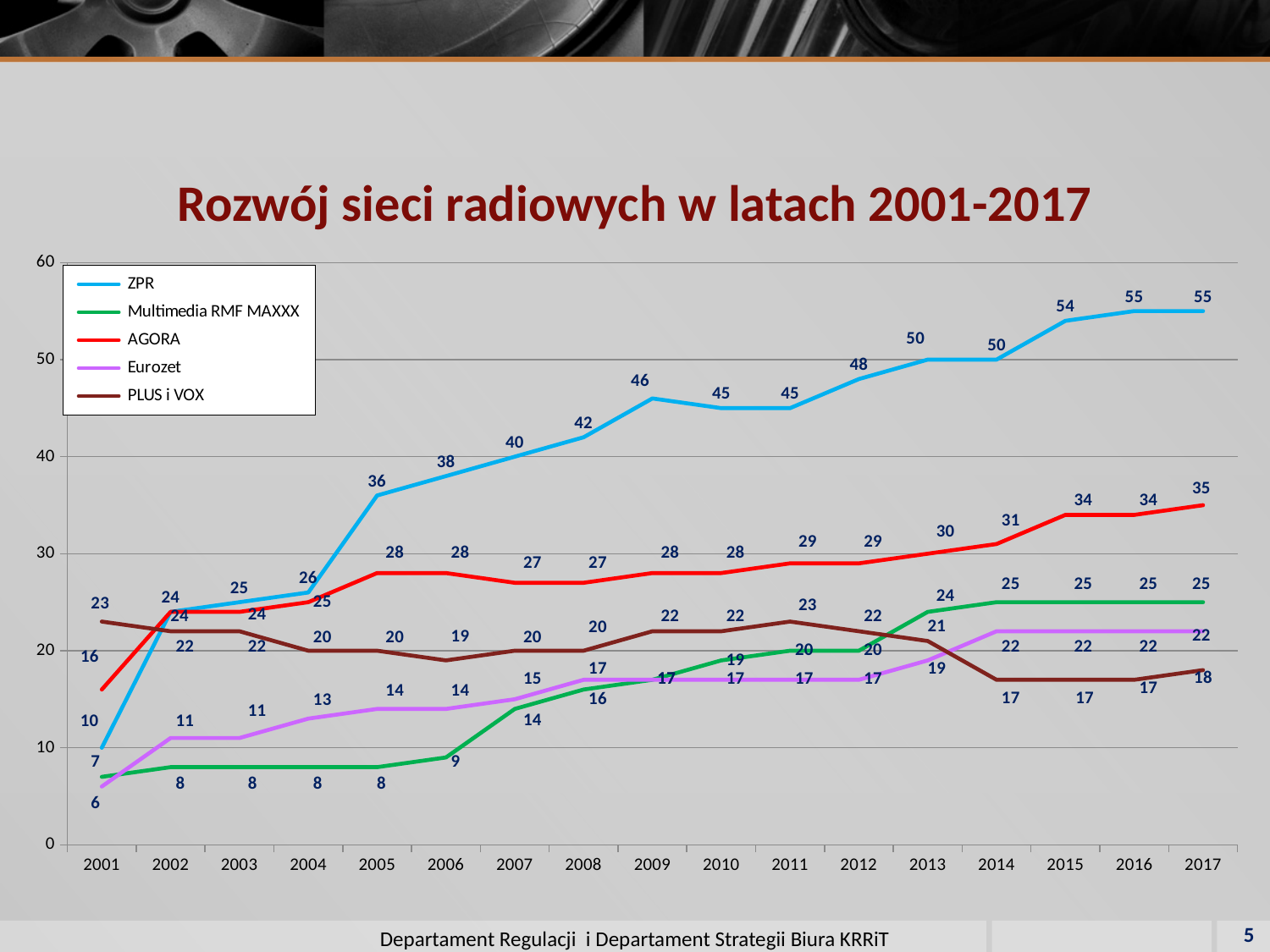
What is the title of the chart? Rozwój sieci radiowych w latach 2001-2017 Which is larger in 2001: the value for PLUS i VOX or the value for AGORA? PLUS i VOX What is the value for PLUS i VOX in 2014? 17 What is the value for AGORA in 2005? 28 What is the value for Eurozet in 2001? 6 What is the value for ZPR in 2017? 55 What type of chart is shown on the slide? line chart What is the difference between the ZPR value in 2017 and the ZPR value in 2001? 45 Which series has the lowest value in 2001? Eurozet Which series has the highest value in 2017? ZPR Does the ZPR series generally rise or fall from 2001 to 2017? rise How many series does the legend list? 5